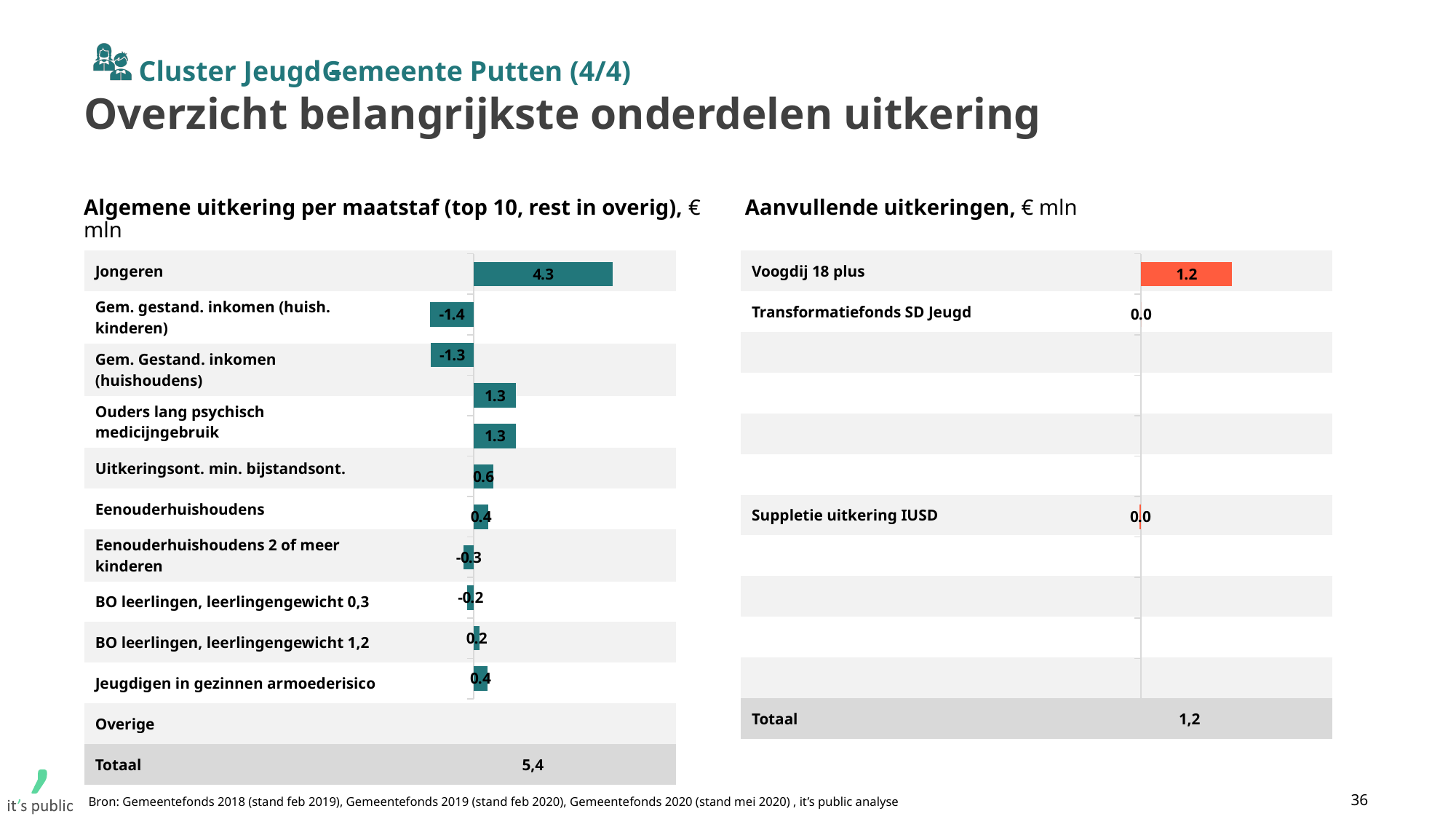
In the left chart 'Algemene uitkering per maatstaf', what is the value shown for Totaal? 5,4 What kind of chart is the left chart 'Algemene uitkering per maatstaf'? Bar chart In the left chart 'Algemene uitkering per maatstaf', what is the value for Jongeren? 4.3 In the left chart 'Algemene uitkering per maatstaf', which category has the lowest value? Gem. gestand. inkomen (huish. kinderen) In the right chart 'Aanvullende uitkeringen', what is the value for Transformatiefonds SD Jeugd? 0.0 In the right chart 'Aanvullende uitkeringen', what is the value for Suppletie uitkering IUSD? 0.0 In the right chart 'Aanvullende uitkeringen', what colour is the bar for Voogdij 18 plus? Orange-red In the left chart 'Algemene uitkering per maatstaf', which category has the highest value? Jongeren In the right chart 'Aanvullende uitkeringen', what is the value for Voogdij 18 plus? 1.2 In the left chart 'Algemene uitkering per maatstaf', what is the value for Gem. gestand. inkomen (huish. kinderen)? -1.4 In the left chart 'Algemene uitkering per maatstaf', which is larger: the value for Jongeren or the value for Gem. gestand. inkomen (huish. kinderen)? Jongeren In the right chart 'Aanvullende uitkeringen', what is the value shown for Totaal? 1,2